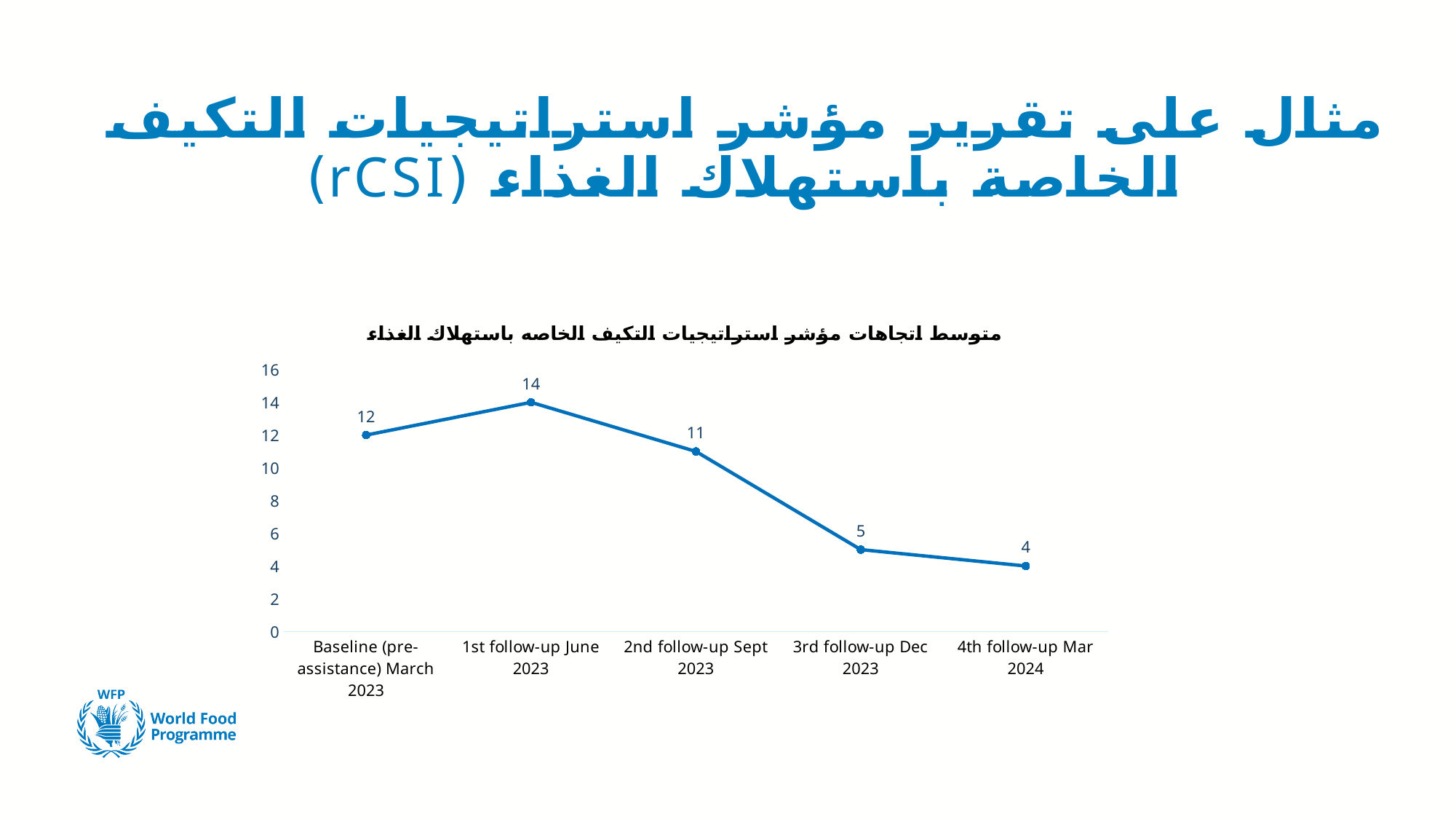
How many data points are plotted on the chart? 5 What is the value at the 2nd follow-up Sept 2023 point? 11 Which point has the lowest value? 4th follow-up Mar 2024 Which is larger, the value at 2nd follow-up Sept 2023 or at 3rd follow-up Dec 2023? 2nd follow-up Sept 2023 What is the difference between the 1st follow-up June 2023 value and the 3rd follow-up Dec 2023 value? 9 What is the value at the Baseline (pre-assistance) March 2023 point? 12 What is the difference between the Baseline (pre-assistance) March 2023 value and the 4th follow-up Mar 2024 value? 8 What kind of chart is shown on the slide? Line chart What is the value at the 4th follow-up Mar 2024 point? 4 Do the values rise or fall from the 1st follow-up June 2023 to the 4th follow-up Mar 2024? Fall Which point has the highest value? 1st follow-up June 2023 What is the value at the 1st follow-up June 2023 point? 14